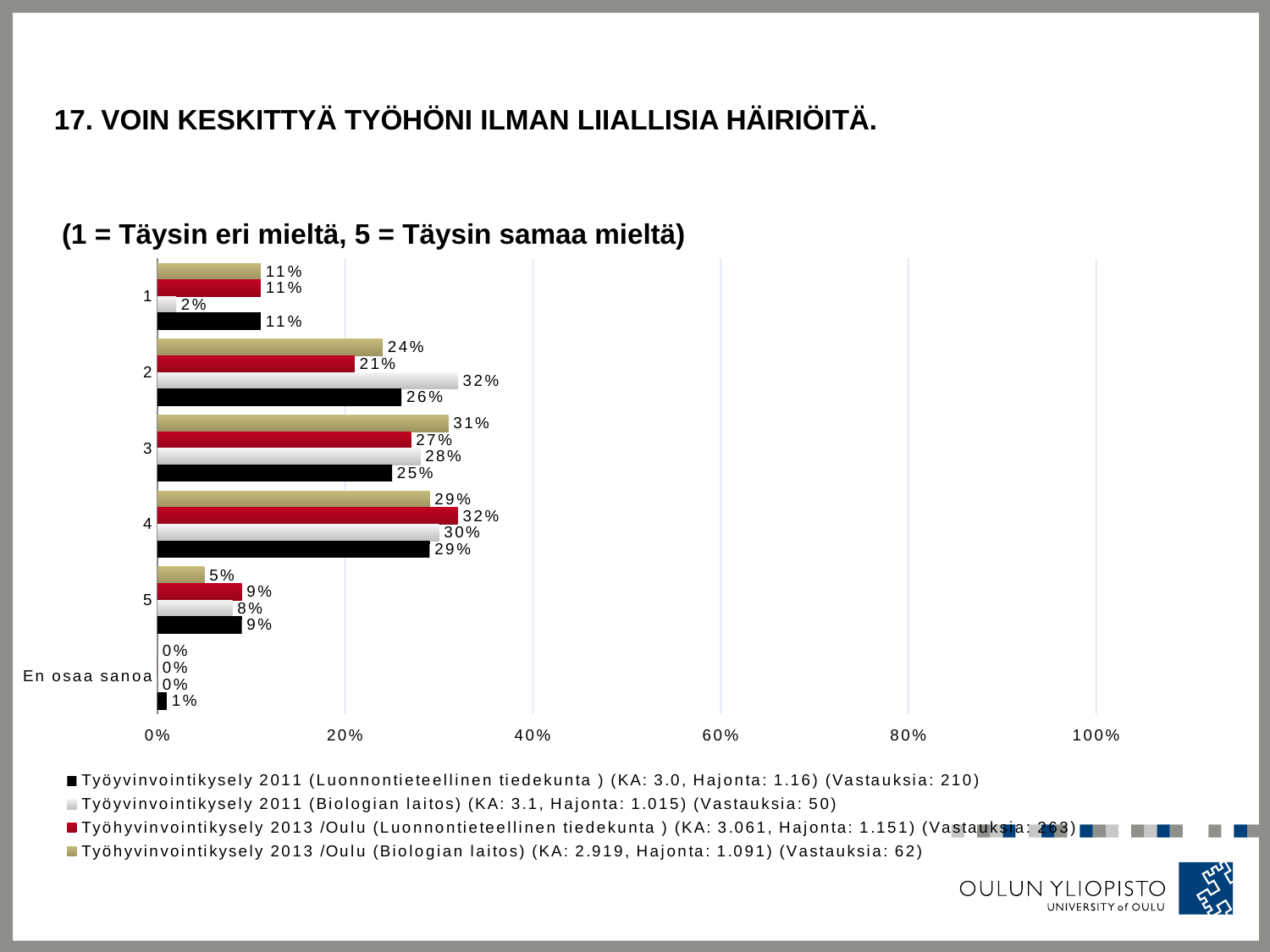
What type of chart is shown on the slide? bar chart How many series does the legend list? 4 What is the value for category 3 in the Työhyvinvointikysely 2013 /Oulu (Biologian laitos) series? 31% For category 5, which is larger: the Työhyvinvointikysely 2013 /Oulu (Biologian laitos) value or the Työhyvinvointikysely 2013 /Oulu (Luonnontieteellinen tiedekunta) value? Työhyvinvointikysely 2013 /Oulu (Luonnontieteellinen tiedekunta) Which category has the highest value in the Työhyvinvointikysely 2013 /Oulu (Luonnontieteellinen tiedekunta) series? 4 What is the value for En osaa sanoa in the Työyvinvointikysely 2011 (Luonnontieteellinen tiedekunta) series? 1% What is the value for category 2 in the Työyvinvointikysely 2011 (Biologian laitos) series? 32% What is the value for category 1 in the Työyvinvointikysely 2011 (Biologian laitos) series? 2% How many categories are shown on the vertical axis? 6 Which category has the lowest value in the Työhyvinvointikysely 2013 /Oulu (Biologian laitos) series? En osaa sanoa Is the value for category 4 in the Työhyvinvointikysely 2013 /Oulu (Luonnontieteellinen tiedekunta) series greater or less than 40%? less What is the difference between the Työyvinvointikysely 2011 (Biologian laitos) value and the Työhyvinvointikysely 2013 /Oulu (Luonnontieteellinen tiedekunta) value for category 2? 11%